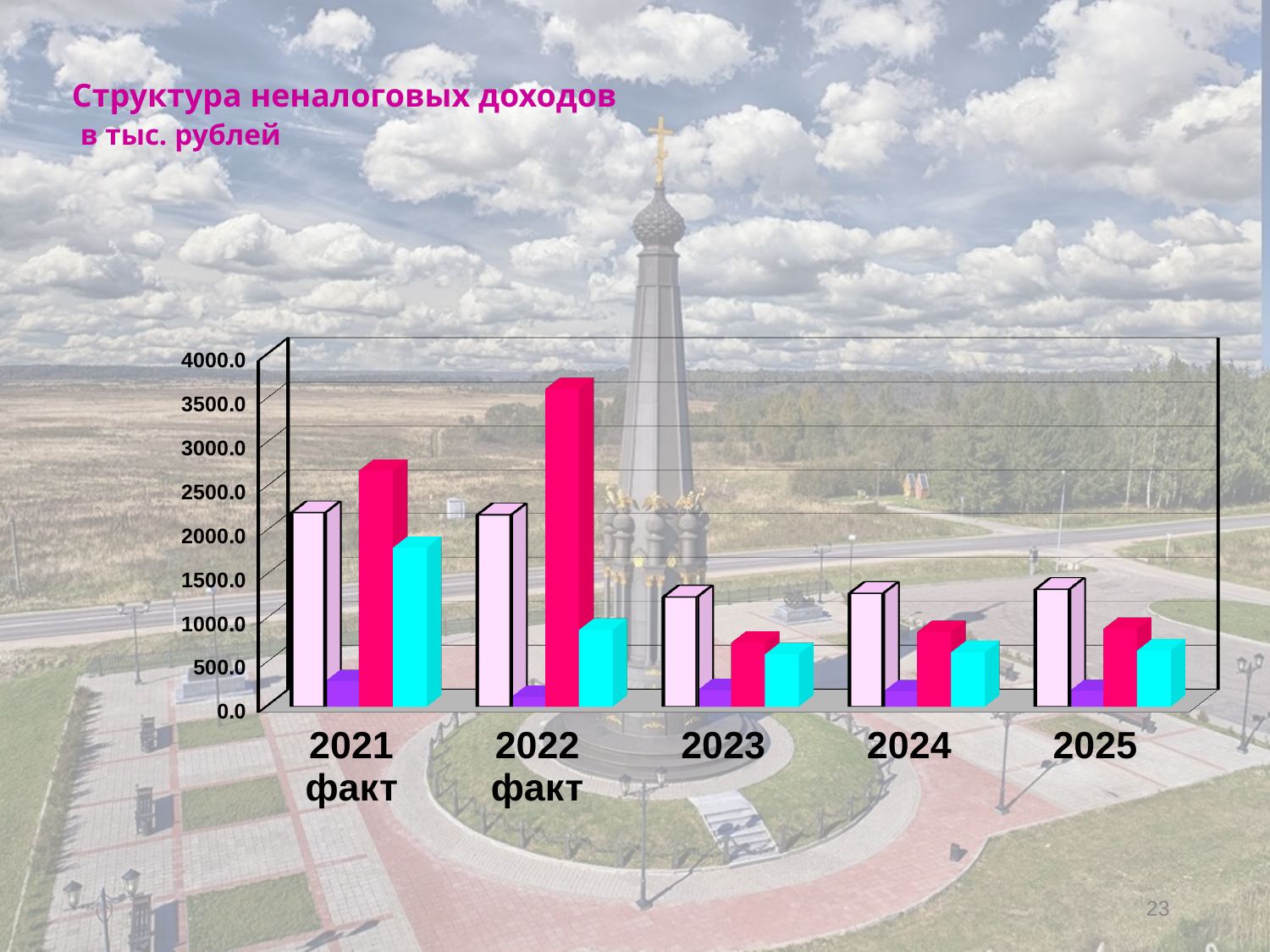
Is the value of the magenta bar for 2022 факт greater or less than 3000.0? greater How many year categories are shown on the x axis of the chart? 5 What kind of chart is shown on the slide? bar chart Is the value of the purple bar for 2023 greater or less than 500.0? less How many bars are plotted for each year category in the chart? 4 In which year is the cyan bar the tallest? 2021 факт For 2023, which is larger: the light pink bar or the magenta bar? the light pink bar What is the title of the chart on the slide? Структура неналоговых доходов в тыс. рублей Is the value of the magenta bar for 2023 greater or less than 1000.0? less In which year is the magenta bar the tallest? 2022 факт